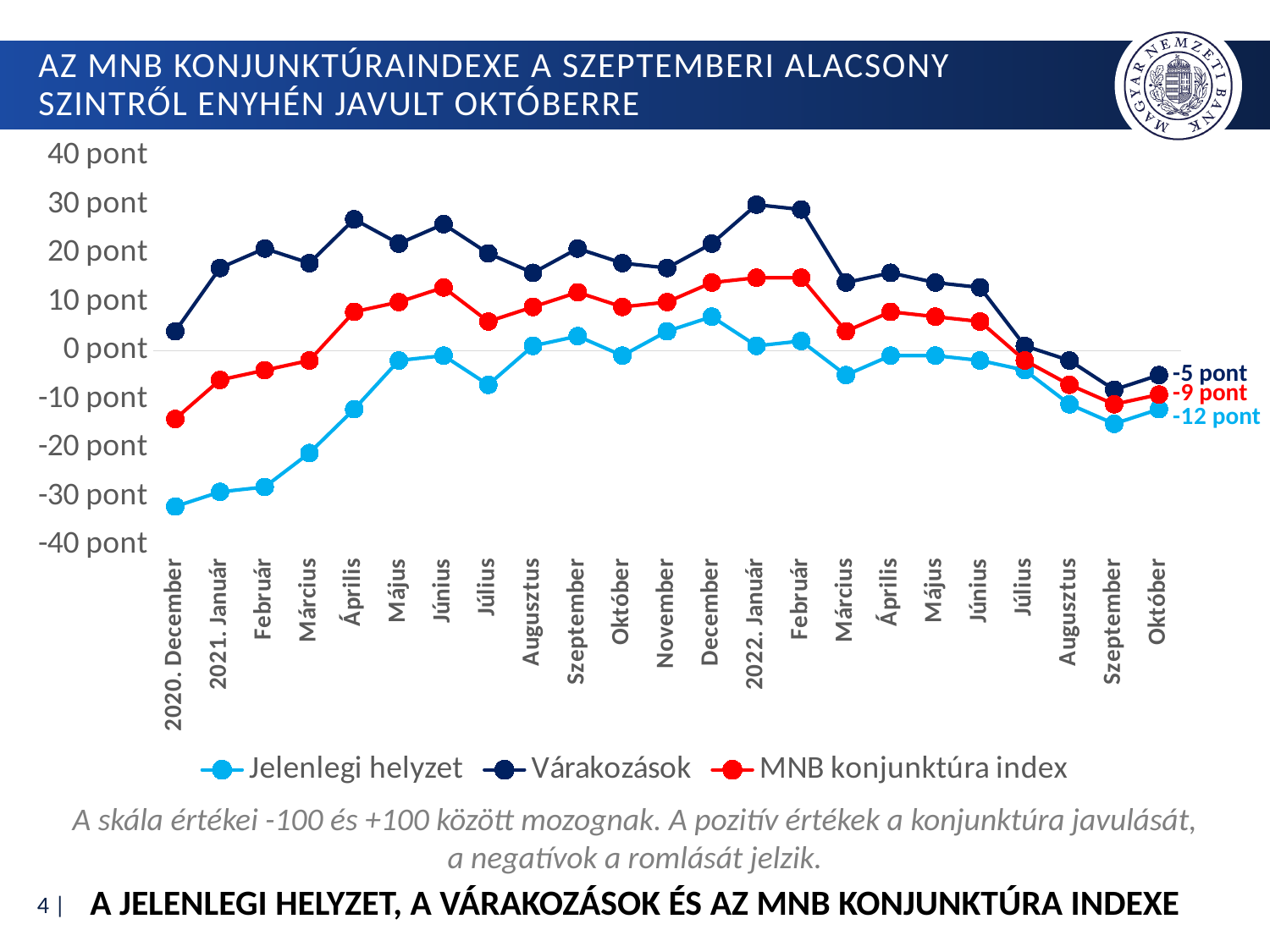
Which series has the highest value in Február 2022? Várakozások In Október 2022, which is higher: the MNB konjunktúra index or the Jelenlegi helyzet value? MNB konjunktúra index Is the Jelenlegi helyzet value for 2020. December greater or less than -30 pont? less In Október 2022, what is the difference between the Várakozások value and the Jelenlegi helyzet value? 7 pont What kind of chart is shown on the slide? line chart What is the value of the Jelenlegi helyzet series for Október 2022? -12 pont Is the Várakozások value for 2022. Január greater or less than 20 pont? greater What is the value of the MNB konjunktúra index for Október 2022? -9 pont How many series does the legend list? 3 How many months (data points) are plotted along the x axis? 23 What is the value of the Várakozások series for Október 2022? -5 pont Does the Jelenlegi helyzet series rise or fall from 2020. December to Június 2021? rise